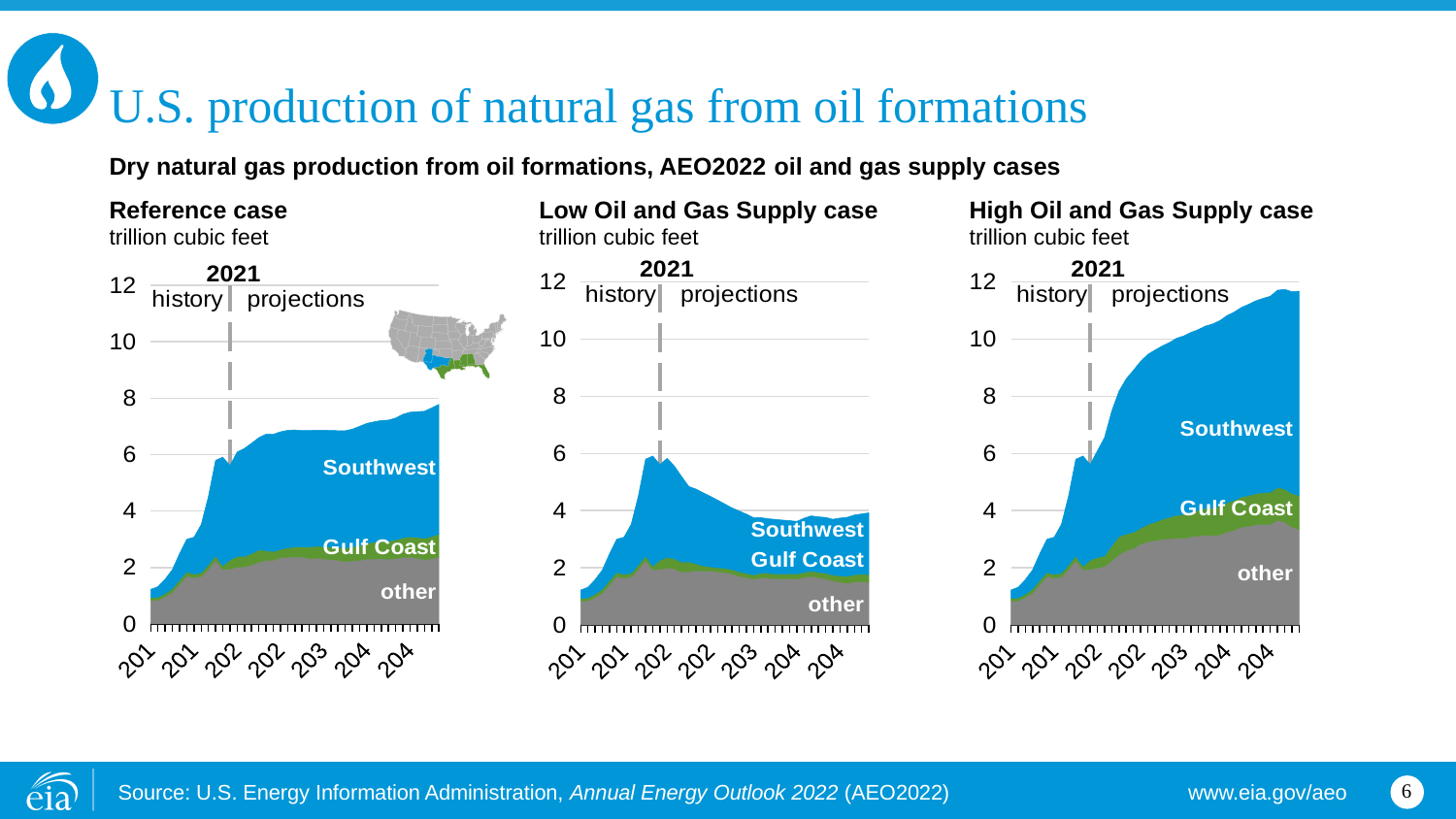
In the High Oil and Gas Supply case chart, is the total production at the end of the projection period greater or less than 10 trillion cubic feet? greater What kind of chart is used for the Reference case? stacked area chart How many series are shown in the Reference case chart? 3 In the Reference case chart, is the total production at the end of the projection period greater or less than 6 trillion cubic feet? greater Which of the three charts reaches the highest total production by the end of the projection period? High Oil and Gas Supply case What unit is used on the y-axis of the three charts? trillion cubic feet In the Reference case chart, is the total production at the end of the projection period greater or less than 8 trillion cubic feet? less In the Reference case chart, which series forms the top layer of the stack? Southwest In the High Oil and Gas Supply case chart, does total production rise or fall over the projection period? rise Is the total production at the end of the projection period larger in the Reference case or in the Low Oil and Gas Supply case? Reference case In the Low Oil and Gas Supply case chart, does total production rise or fall after its peak around 2021? fall